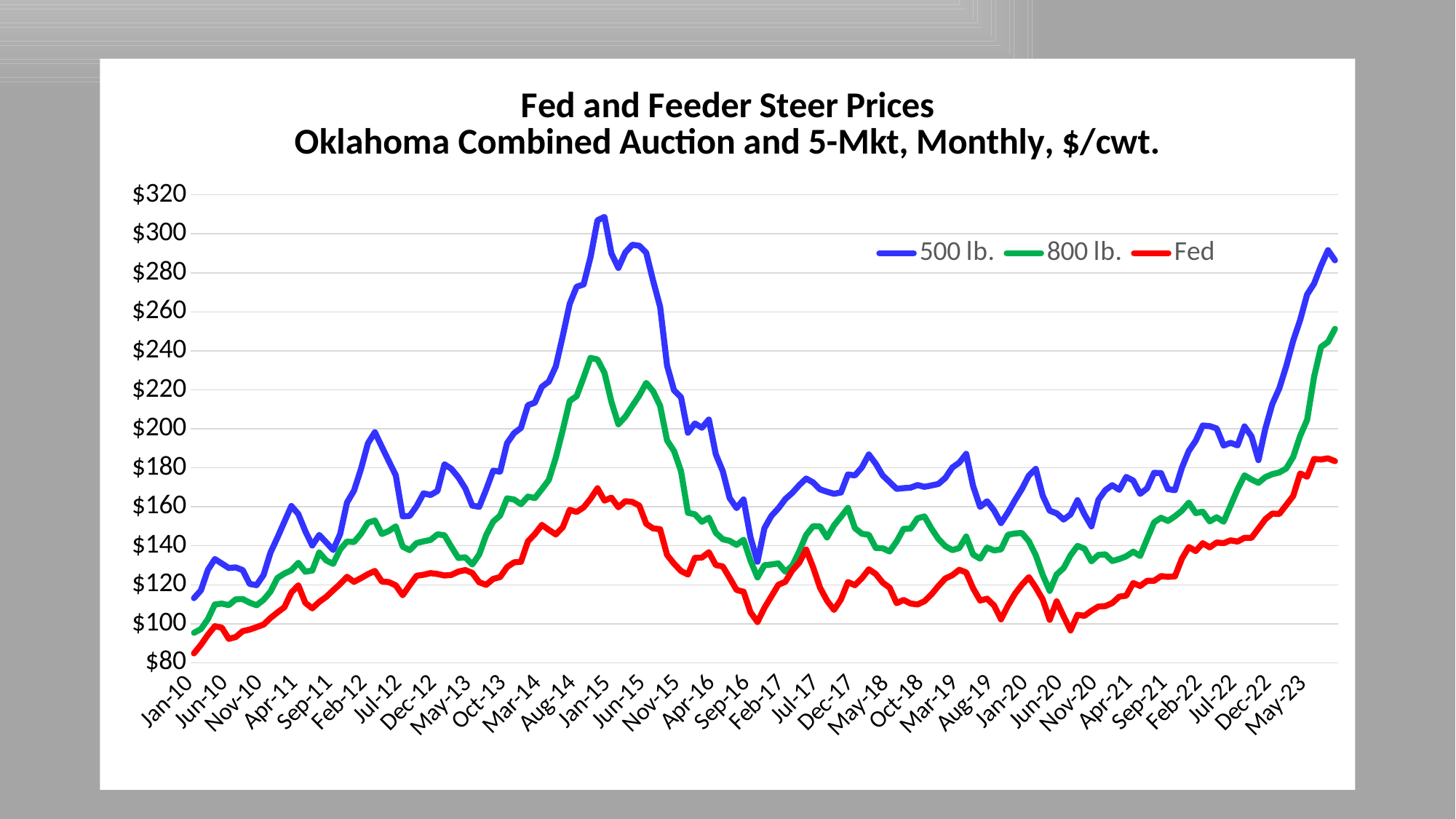
Does the 500 lb. series rise or fall between Jan-15 and Sep-16? Fall Which series has the highest values across the chart? 500 lb. At Jan-15, which is larger: the 500 lb. series or the Fed series? 500 lb. What kind of chart is shown on the slide? Line chart Is the value for the 500 lb. series at Jan-10 greater or less than $120? less How many series does the legend list? 3 Which colour is used for the Fed series? Red Is the value for the 500 lb. series at its peak around Jan-15 greater or less than $300? greater What are the three series named in the legend? 500 lb., 800 lb., Fed Is the value for the Fed series at Jan-10 greater or less than $100? less Which series has the lowest values across the chart? Fed